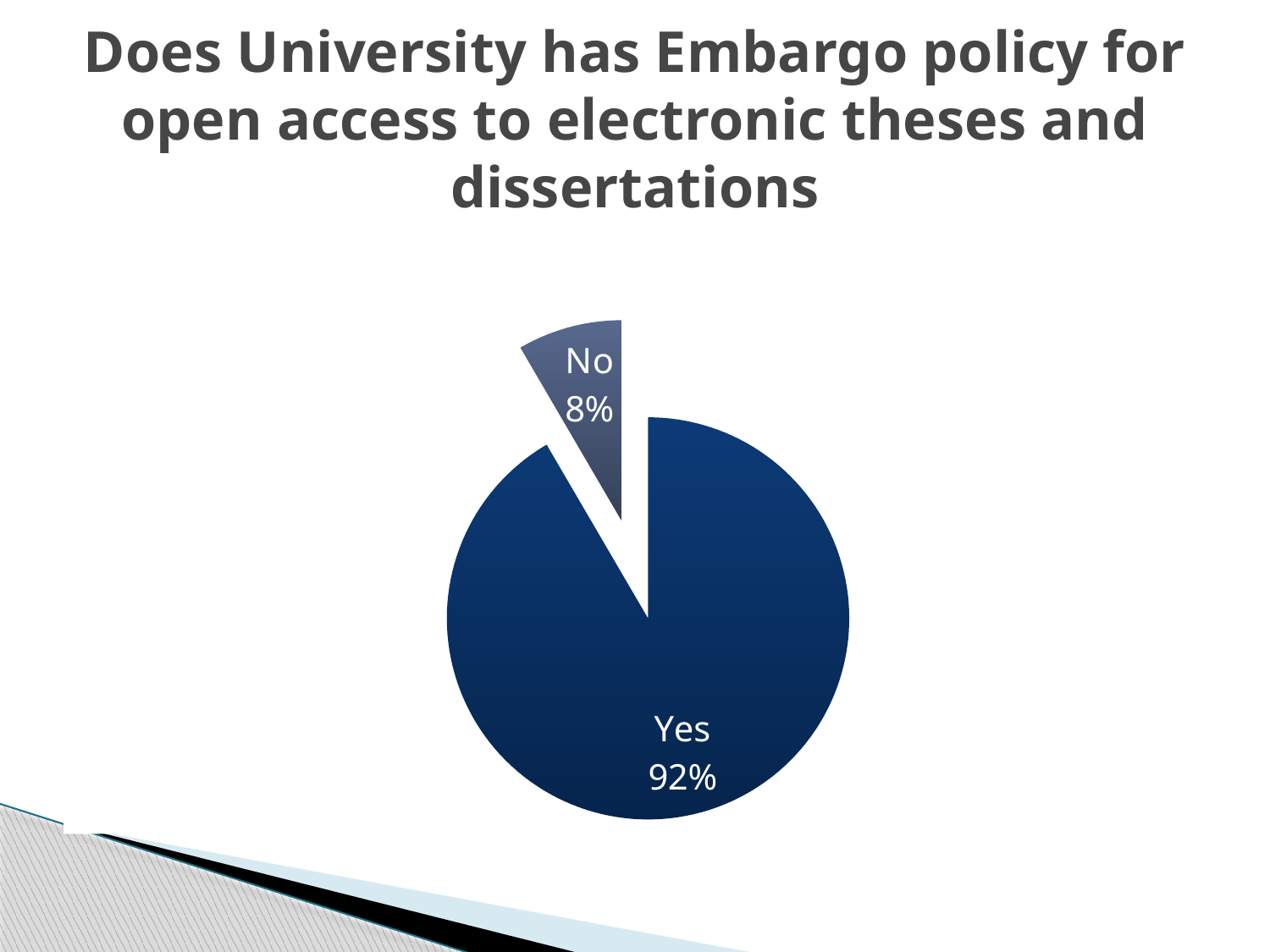
Which response has the largest share of the pie? Yes What kind of chart is shown on the slide? pie chart What percentage of respondents answered No? 8% What percentage of respondents answered Yes? 92% What is the difference in percentage points between the Yes and No slices? 84 What is the title of the chart on the slide? Does University has Embargo policy for open access to electronic theses and dissertations Which slice is pulled out (exploded) from the pie? No How many slices does the pie chart have? 2 What share of the pie does the No slice represent? 8% Which response has the smallest share of the pie? No Which is larger, the Yes slice or the No slice? Yes